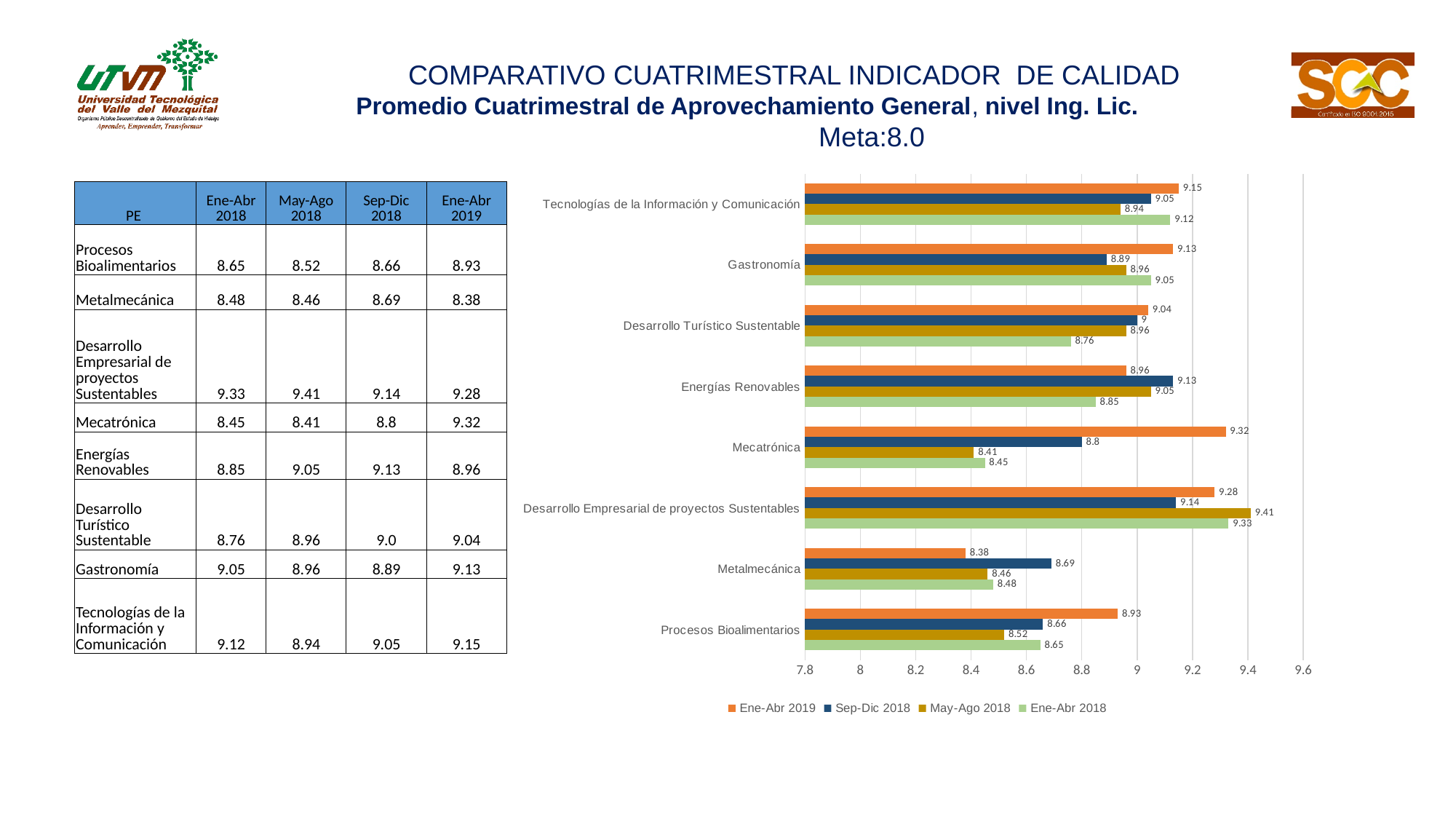
How many series does the legend list? 4 What is the Ene-Abr 2019 value for Mecatrónica? 9.32 Which category has the lowest Ene-Abr 2019 value? Metalmecánica What is the Ene-Abr 2018 value for Desarrollo Turístico Sustentable? 8.76 What is the May-Ago 2018 value for Desarrollo Empresarial de proyectos Sustentables? 9.41 What is the difference between the Ene-Abr 2019 and Ene-Abr 2018 values for Mecatrónica? 0.87 How many categories (programs) are shown on the chart? 8 Which category has the highest Ene-Abr 2019 value? Mecatrónica Is the Ene-Abr 2019 value for Metalmecánica greater or less than 8.4? less Which is larger for Energías Renovables: the Sep-Dic 2018 value or the Ene-Abr 2019 value? Sep-Dic 2018 What is the Sep-Dic 2018 value for Procesos Bioalimentarios? 8.66 What kind of chart is shown on the slide? Bar chart